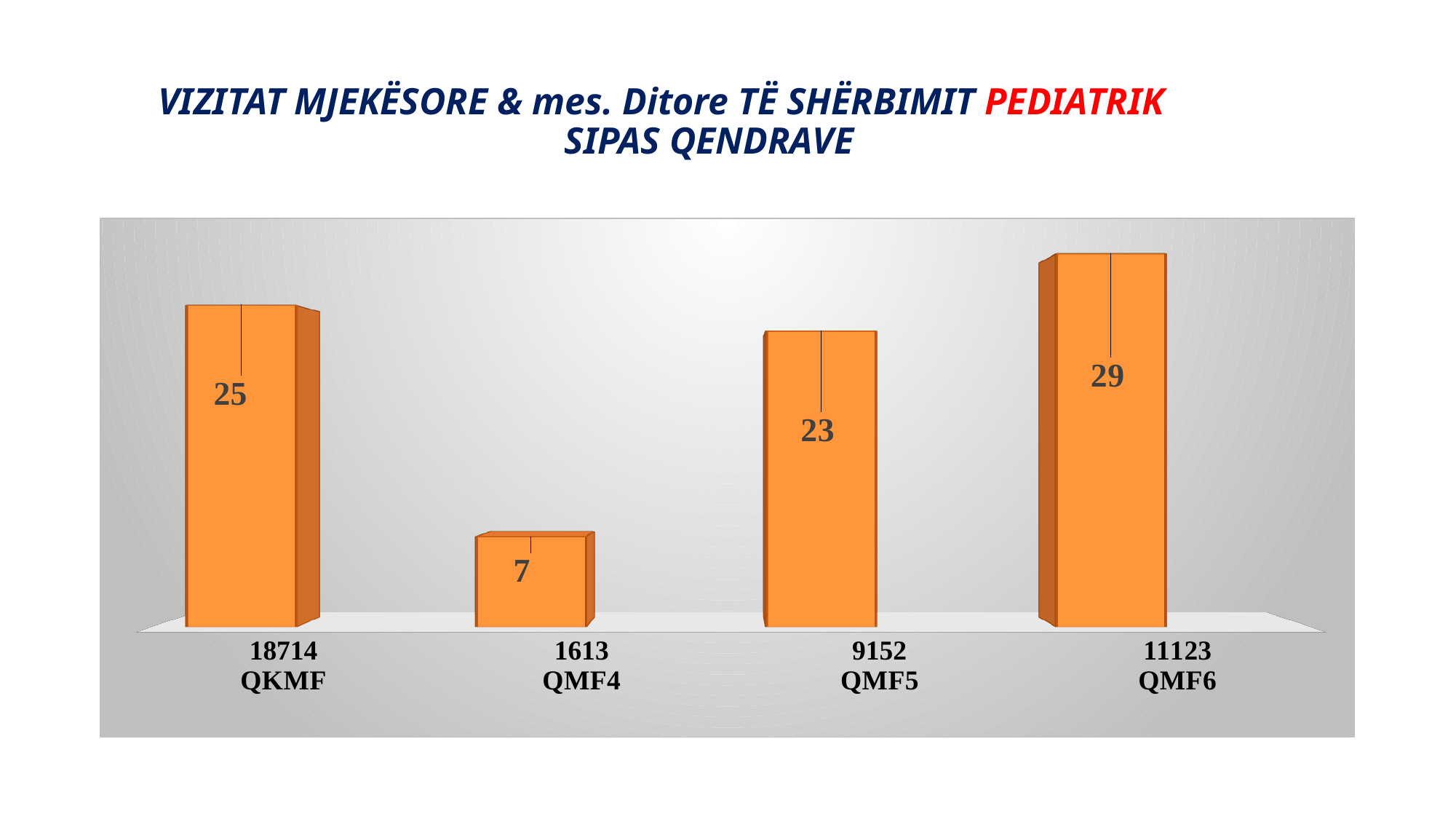
What is the difference between the data labels for QMF6 and QMF4? 22 Which centre has the lowest bar? QMF4 Which centre has the highest bar? QMF6 What is the difference between the data labels for QKMF and QMF5? 2 What number is printed above the label QKMF on the category axis? 18714 What is the data label on the bar for QMF6? 29 What kind of chart is shown on the slide? Bar chart What is the data label on the bar for QKMF? 25 What is the data label on the bar for QMF5? 23 What is the data label on the bar for QMF4? 7 How many centres (bars) are shown in the chart? 4 Which is larger, the value for QKMF or the value for QMF5? QKMF